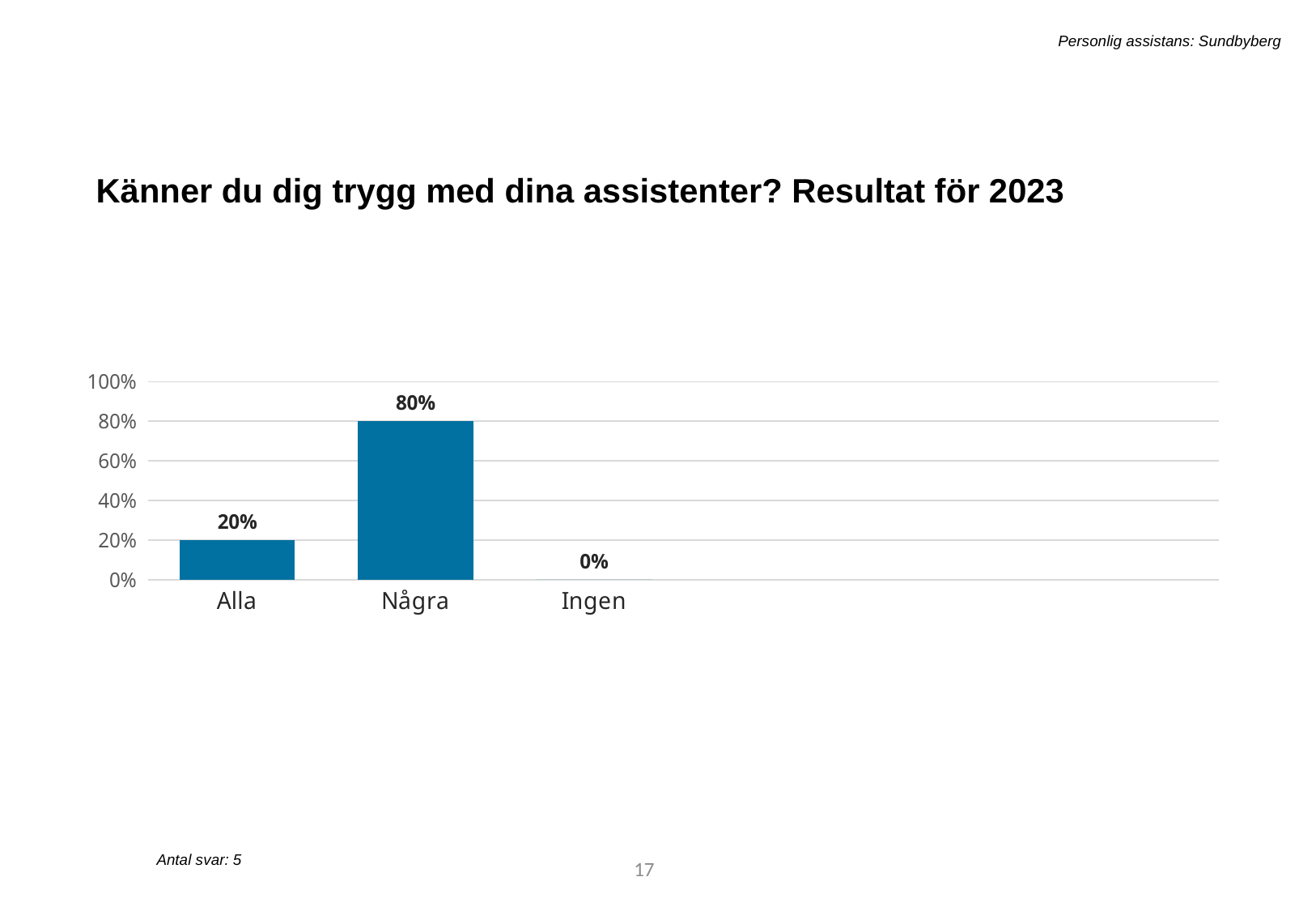
Which is larger, the value for Alla or the value for Några? Några What kind of chart is shown on the slide? bar chart What is the value for Alla? 20% Which category has the lowest value? Ingen What is the title of the chart? Känner du dig trygg med dina assistenter? Resultat för 2023 What is the value for Några? 80% Is the value for Några greater or less than 60%? greater Which category has the highest value? Några How many categories are shown on the x axis? 3 What is the value for Ingen? 0% What is the highest value shown on the y axis? 100% What is the difference between the values for Några and Alla? 60%